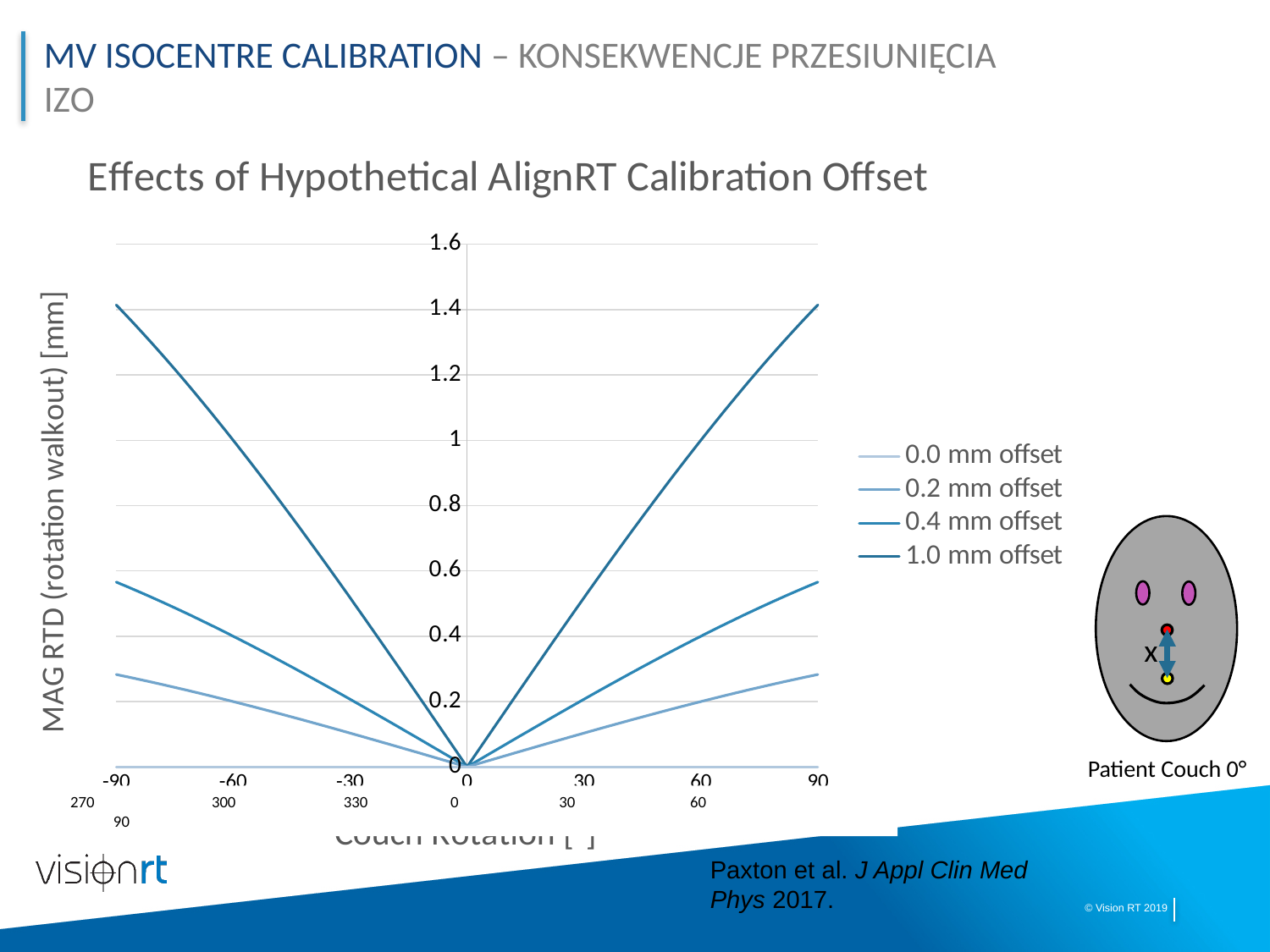
Is the value for the 1.0 mm offset series at a couch rotation of 90 greater or less than 1.2? greater At a couch rotation of 60, which series has the larger value: 0.4 mm offset or 0.2 mm offset? 0.4 mm offset What is the title of the chart? Effects of Hypothetical AlignRT Calibration Offset Is the value for the 0.4 mm offset series at a couch rotation of -90 greater or less than 0.6? less Is the value for the 0.2 mm offset series at a couch rotation of 90 greater or less than 0.4? less How many series does the chart legend list? 4 Which series reaches the highest value at a couch rotation of 90? 1.0 mm offset What type of chart is shown on the slide? line chart What is the value of the 1.0 mm offset series at a couch rotation of 0? 0 What is the label of the vertical axis of the chart? MAG RTD (rotation walkout) [mm] How do the values of the 1.0 mm offset series change as couch rotation increases from 0 to 90? they rise Which series has the lowest values across the whole couch rotation range? 0.0 mm offset